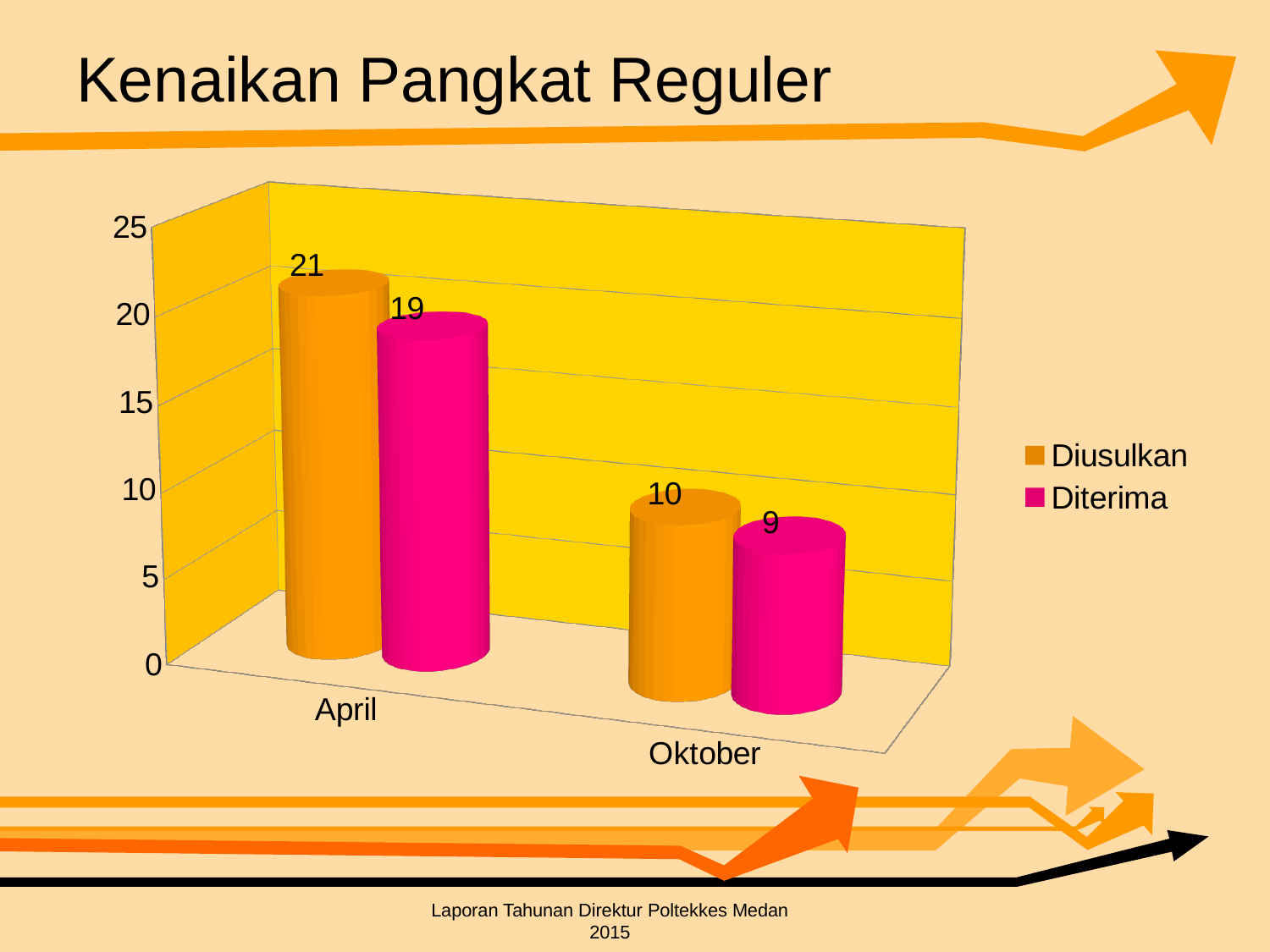
What kind of chart is shown on the slide? Bar chart What is the Diusulkan value for Oktober? 10 Which category has the lowest Diterima value? Oktober What is the Diterima value for Oktober? 9 Which category has the highest Diusulkan value? April What is the Diusulkan value for April? 21 How many categories are shown on the x axis? 2 What is the difference between the Diusulkan values for April and Oktober? 11 Which is larger, the Diterima value for April or the Diterima value for Oktober? April How many series does the legend list? 2 What is the difference between the Diusulkan and Diterima values for April? 2 What is the Diterima value for April? 19